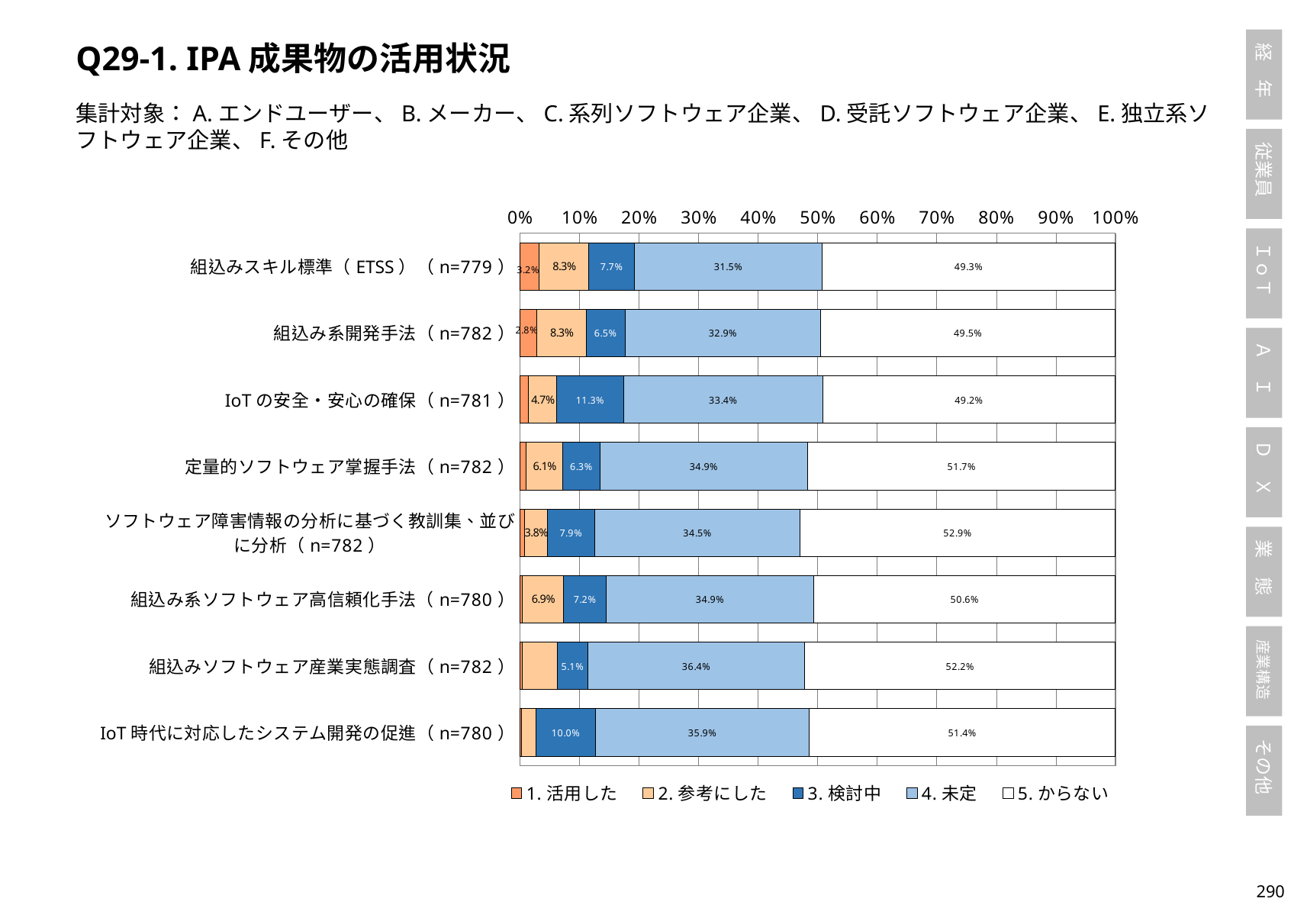
What is the value of 4. 未定 for 組込みスキル標準（ETSS）(n=779)? 31.5% Which category has the highest value for 3. 検討中? IoTの安全・安心の確保 (n=781) What kind of chart is shown on the slide? Stacked bar chart Which category has the lowest value for 4. 未定? 組込みスキル標準（ETSS）(n=779) How many categories are shown on the chart? 8 What is the difference between the 4. 未定 values for 組込みソフトウェア産業実態調査 (n=782) and 組込みスキル標準（ETSS）(n=779)? 4.9 percentage points What is the value of 1. 活用した for 組込み系開発手法 (n=782)? 2.8% Which is larger: the 2. 参考にした value for 組込み系ソフトウェア高信頼化手法 (n=780) or for 定量的ソフトウェア掌握手法 (n=782)? 組込み系ソフトウェア高信頼化手法 (n=780) How many series does the legend list? 5 Which category has the highest value for 5. わからない? ソフトウェア障害情報の分析に基づく教訓集、並びに分析 (n=782) What is the value of 3. 検討中 for IoTの安全・安心の確保 (n=781)? 11.3% What is the value of 5. わからない for 組込みソフトウェア産業実態調査 (n=782)? 52.2%